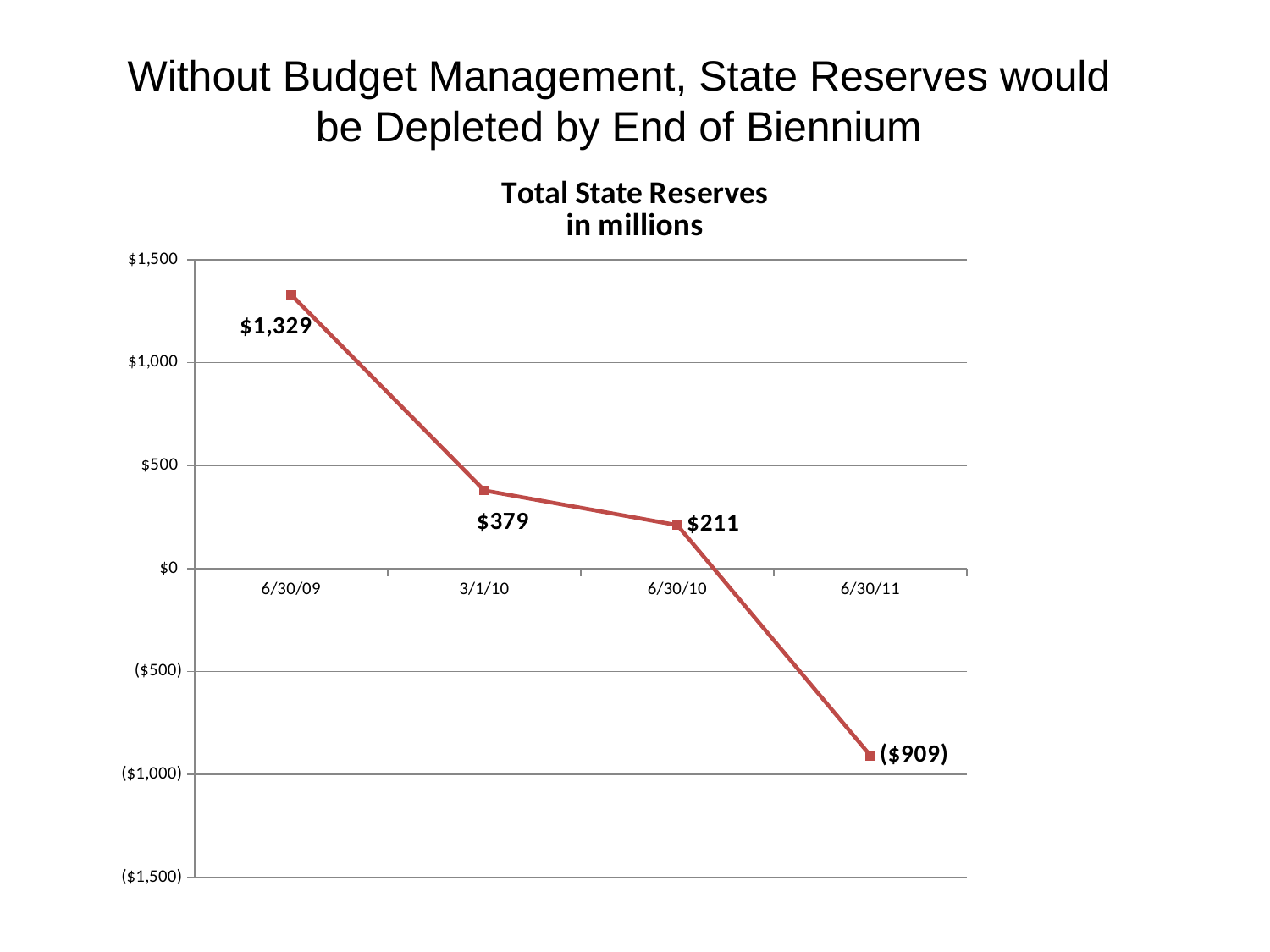
What is the value of Total State Reserves on 6/30/11? ($909) Which is larger, the reserves on 3/1/10 or on 6/30/10? 3/1/10 Do Total State Reserves rise or fall from 6/30/09 to 6/30/11? Fall How many data points are plotted on the chart? 4 What is the value of Total State Reserves on 3/1/10? $379 What kind of chart is shown on the slide? Line chart On which date are Total State Reserves highest? 6/30/09 What is the value of Total State Reserves on 6/30/09? $1,329 What is the value of Total State Reserves on 6/30/10? $211 What is the difference between the reserves on 3/1/10 and 6/30/10? $168 What is the difference between the reserves on 6/30/09 and 3/1/10? $950 On which date are Total State Reserves lowest? 6/30/11